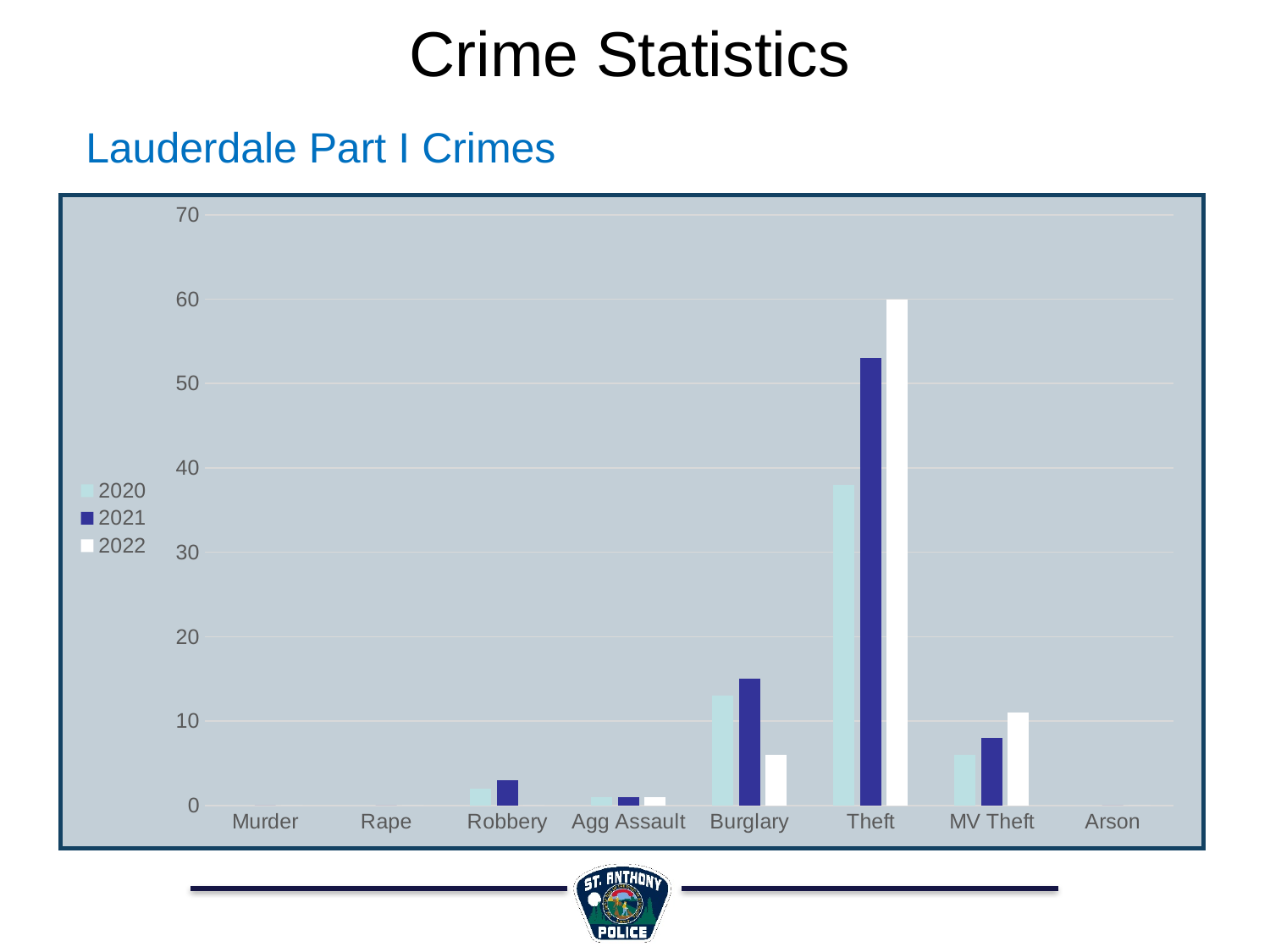
For Burglary, which year has the larger value, 2021 or 2022? 2021 How many crime categories are shown on the x axis? 8 Is the value for Theft in 2020 greater or less than 40? less What kind of chart is shown on the slide? bar chart Do the Theft values rise or fall from 2020 to 2022? rise Which crime category has the highest value for 2022? Theft Is the value for Burglary in 2021 greater or less than 10? greater Is the value for Theft in 2021 greater or less than 50? greater What is the value for Theft in 2022? 60 For MV Theft, which year has the larger value, 2020 or 2022? 2022 What are the entries listed in the legend? 2020, 2021, 2022 How many series does the legend list? 3